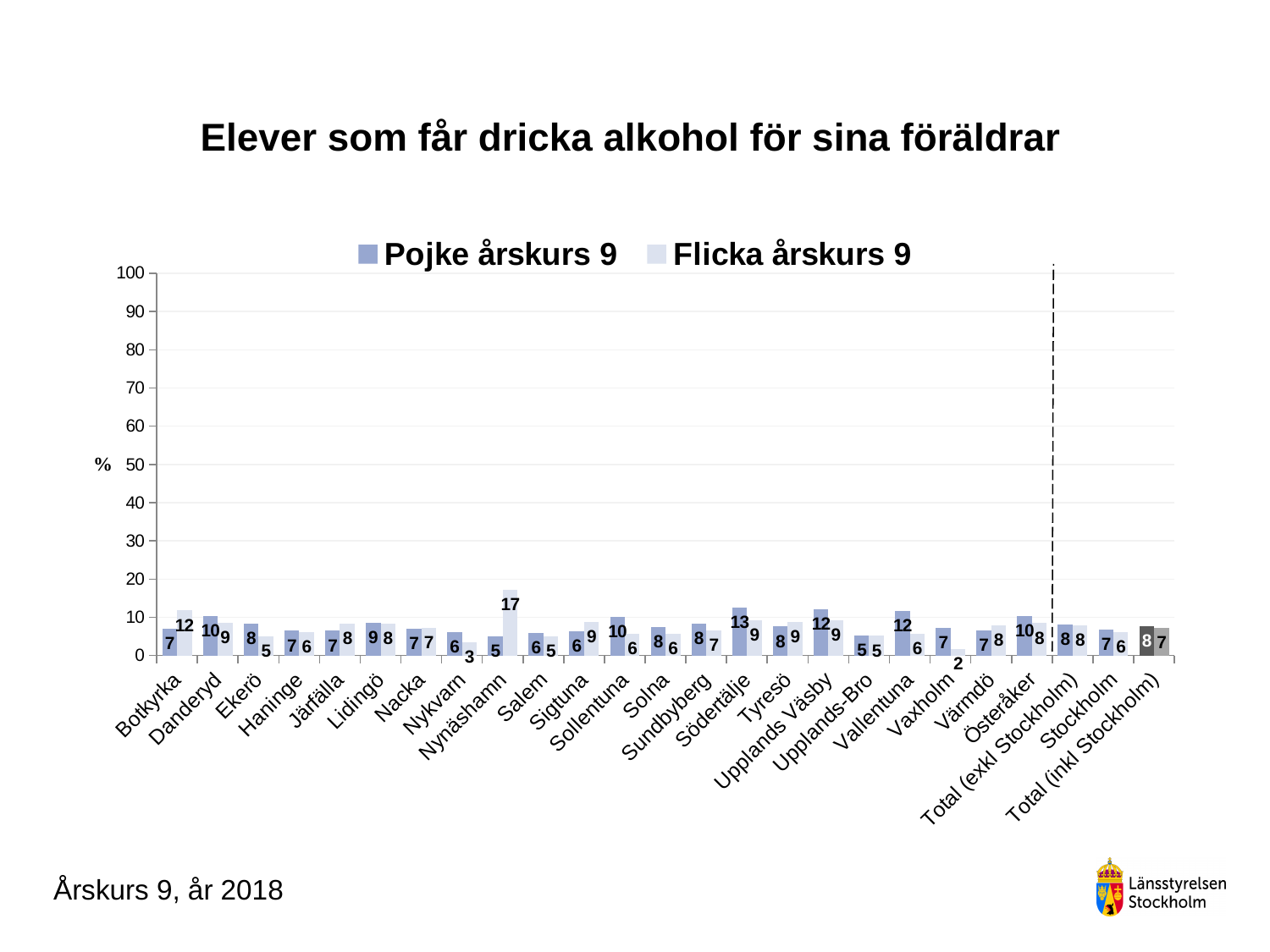
Which category has the highest value for Pojke årskurs 9? Södertälje How many categories are shown on the x axis? 25 What kind of chart is shown on the slide? Bar chart Which is larger in Botkyrka: the Pojke årskurs 9 value or the Flicka årskurs 9 value? Flicka årskurs 9 Which category has the highest value for Flicka årskurs 9? Nynäshamn Which category has the lowest value for Flicka årskurs 9? Vaxholm What is the value for Flicka årskurs 9 in Vaxholm? 2 What is the value for Flicka årskurs 9 in Nynäshamn? 17 How many series does the legend list? 2 What is the difference between the Flicka årskurs 9 and Pojke årskurs 9 values in Nynäshamn? 12 What is the value for Pojke årskurs 9 in Södertälje? 13 What is the title of the chart? Elever som får dricka alkohol för sina föräldrar